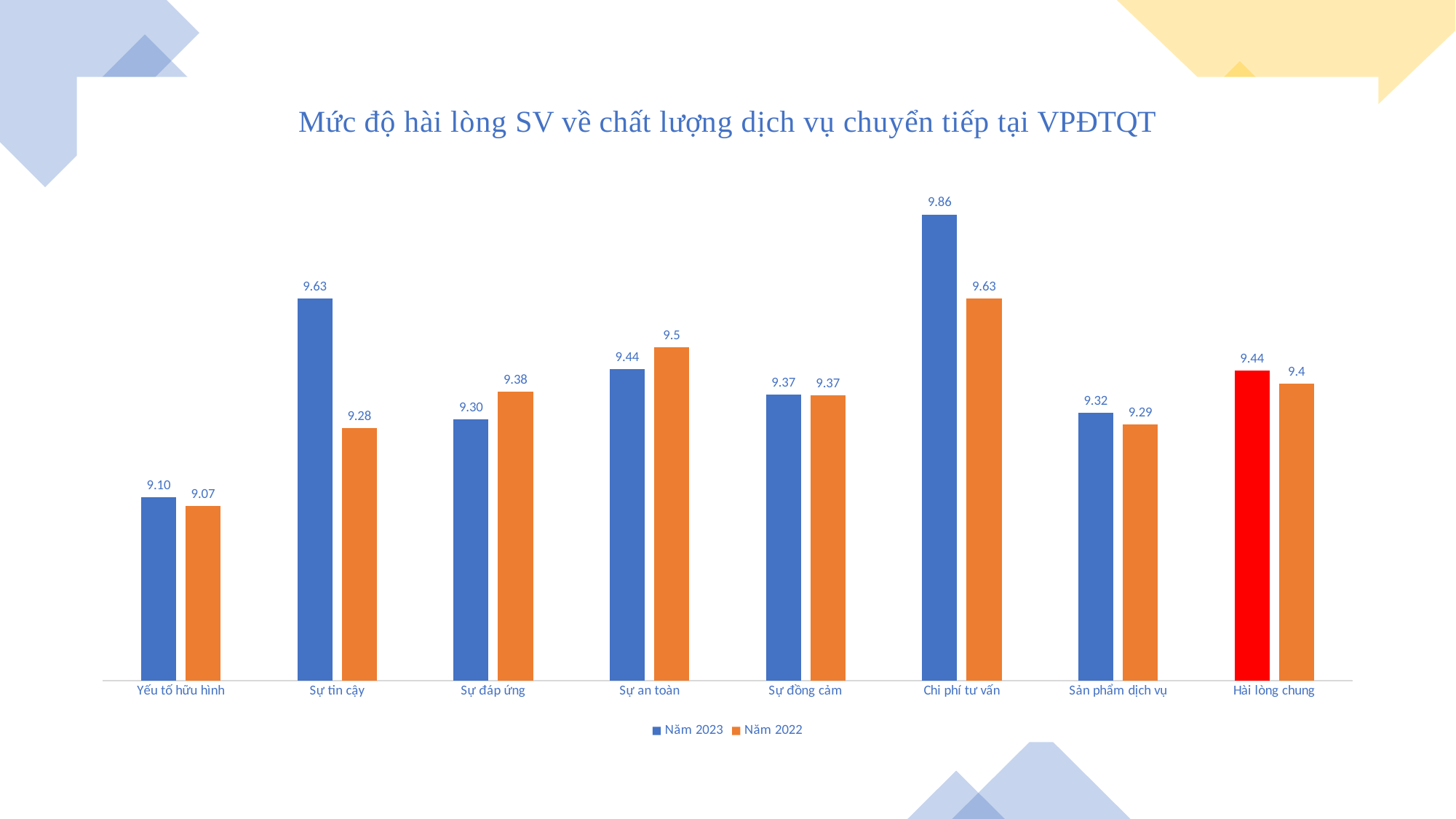
What is the title of the chart? Mức độ hài lòng SV về chất lượng dịch vụ chuyển tiếp tại VPĐTQT How many categories are shown on the x axis? 8 What is the value for Năm 2023 in the Chi phí tư vấn category? 9.86 How many series does the legend list? 2 What is the value for Năm 2022 in the Hài lòng chung category? 9.4 Which category has the highest value for Năm 2023? Chi phí tư vấn What is the value for Năm 2022 in the Sự tin cậy category? 9.28 What is the difference between the Năm 2023 and Năm 2022 values for Sự tin cậy? 0.35 What kind of chart is shown on the slide? Bar chart Which category has the lowest value for Năm 2022? Yếu tố hữu hình Which category's Năm 2023 bar is coloured red instead of blue? Hài lòng chung Which is larger for Sự an toàn: the Năm 2023 value or the Năm 2022 value? Năm 2022